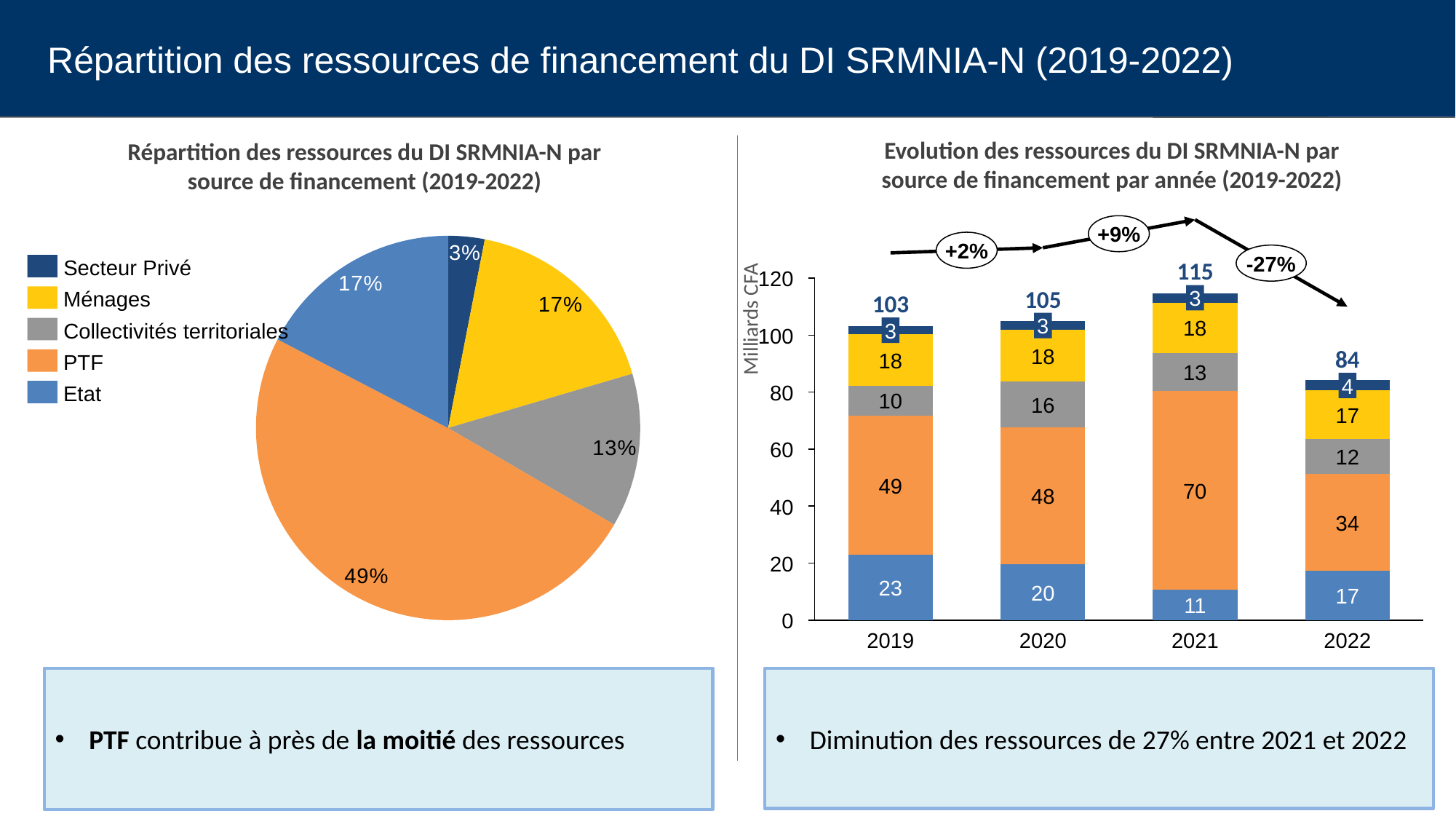
On the bar chart on the right, what is the total for 2022? 84 On the bar chart on the right, what is the value of the orange (PTF) segment in 2021? 70 On the bar chart on the right, is the total for 2020 greater or less than 100? greater On the pie chart on the left, what share of resources comes from Collectivités territoriales? 13% On the pie chart on the left, what share of resources comes from PTF? 49% On the bar chart on the right, what is the total for 2021? 115 On the bar chart on the right, what percentage change is shown between 2021 and 2022? -27% On the bar chart on the right, which year has the highest total? 2021 On the bar chart on the right, what is the difference between the totals for 2021 and 2022? 31 On the pie chart on the left, which source has the smallest share? Secteur Privé What kind of chart is the chart on the right (Evolution des ressources du DI SRMNIA-N)? Stacked bar chart How many categories does the legend of the pie chart on the left list? 5